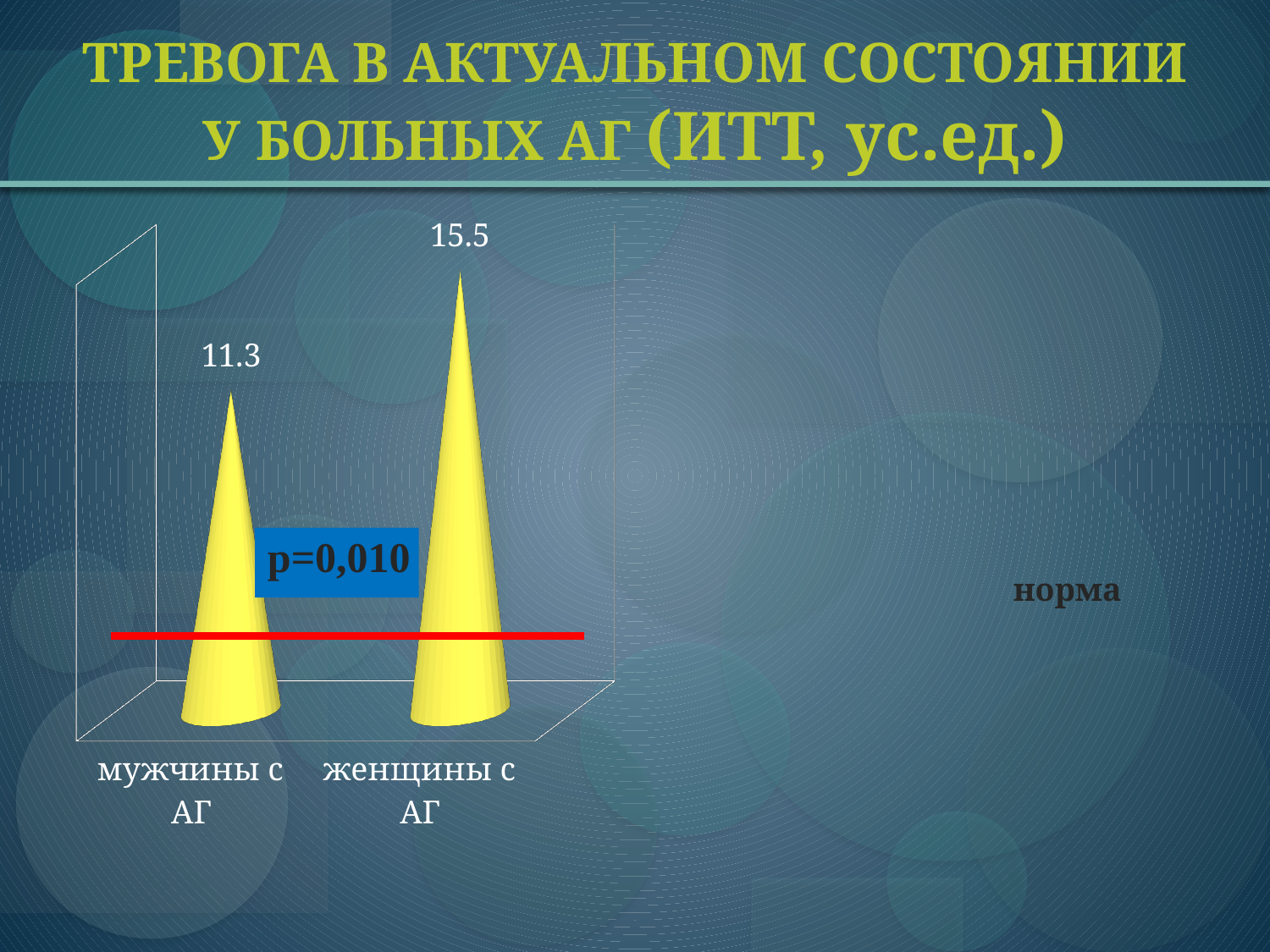
Which category has the lowest value? мужчины с АГ What does the red horizontal line on the chart represent, according to its label? норма What is the value for мужчины с АГ? 11.3 How many categories are shown in the chart? 2 What is the value for женщины с АГ? 15.5 What is the difference between the values for женщины с АГ and мужчины с АГ? 4.2 Which is larger, the value for мужчины с АГ or the value for женщины с АГ? женщины с АГ What kind of chart is shown on the slide? bar chart Which category has the highest value? женщины с АГ What p-value is shown on the chart? p=0,010